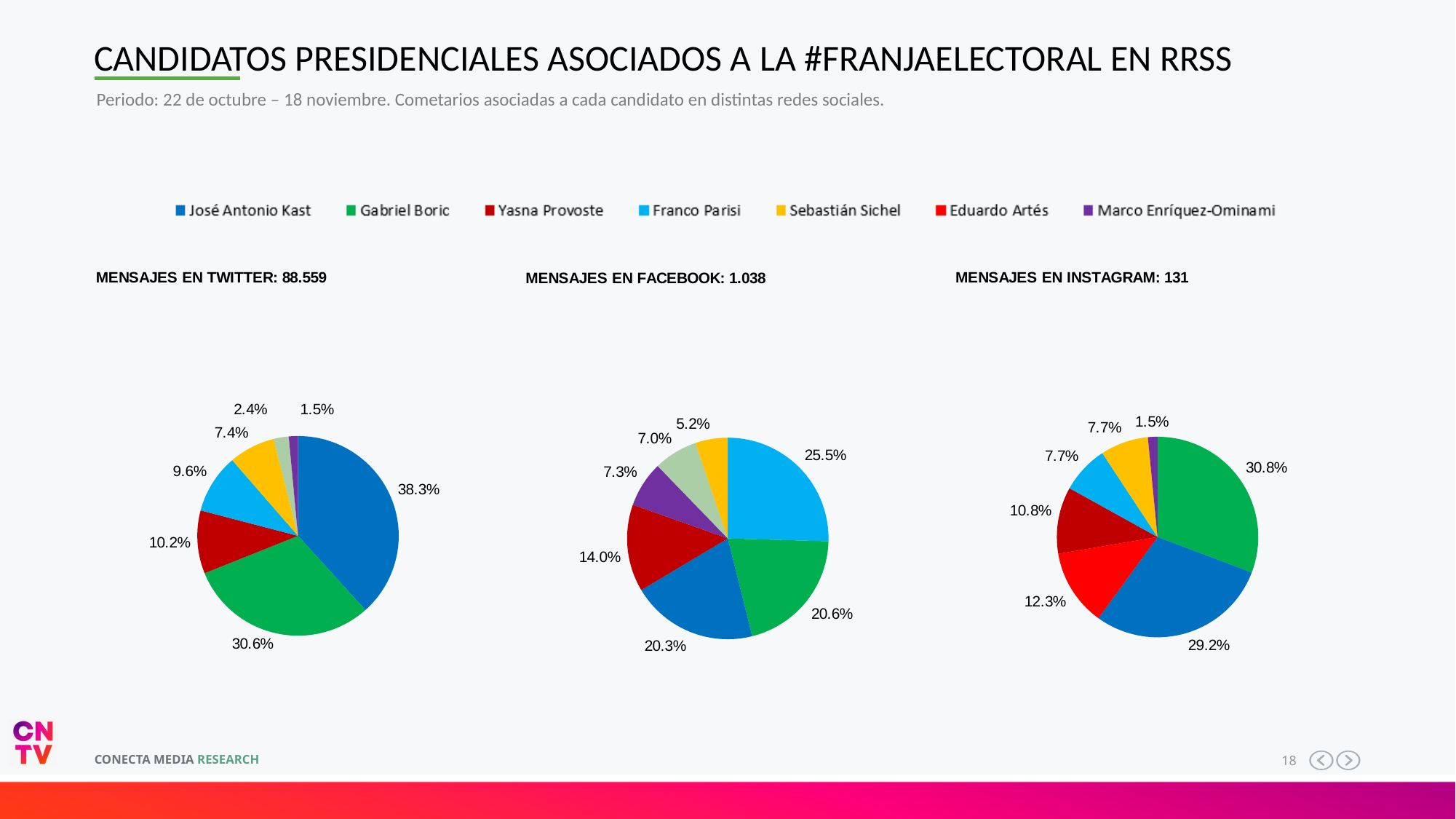
In the 'Mensajes en Twitter' chart, what share of messages is associated with José Antonio Kast? 38.3% How many candidates does the legend list? 7 In the 'Mensajes en Instagram' chart, what share of messages is associated with Gabriel Boric? 30.8% In the 'Mensajes en Twitter' chart, what share of messages is associated with Gabriel Boric? 30.6% How many messages in total does the 'Mensajes en Facebook' chart represent, according to its title? 1.038 In the 'Mensajes en Instagram' chart, which is larger: the share for Eduardo Artés or the share for Yasna Provoste? Eduardo Artés In the 'Mensajes en Facebook' chart, which candidate has the largest slice? Franco Parisi In the 'Mensajes en Twitter' chart, which candidate has the largest slice? José Antonio Kast What kind of charts are shown on the slide? Pie charts In the 'Mensajes en Facebook' chart, what is the difference between Yasna Provoste's share and Sebastián Sichel's share? 8.8% In the 'Mensajes en Instagram' chart, which candidate has the smallest slice? Marco Enríquez-Ominami